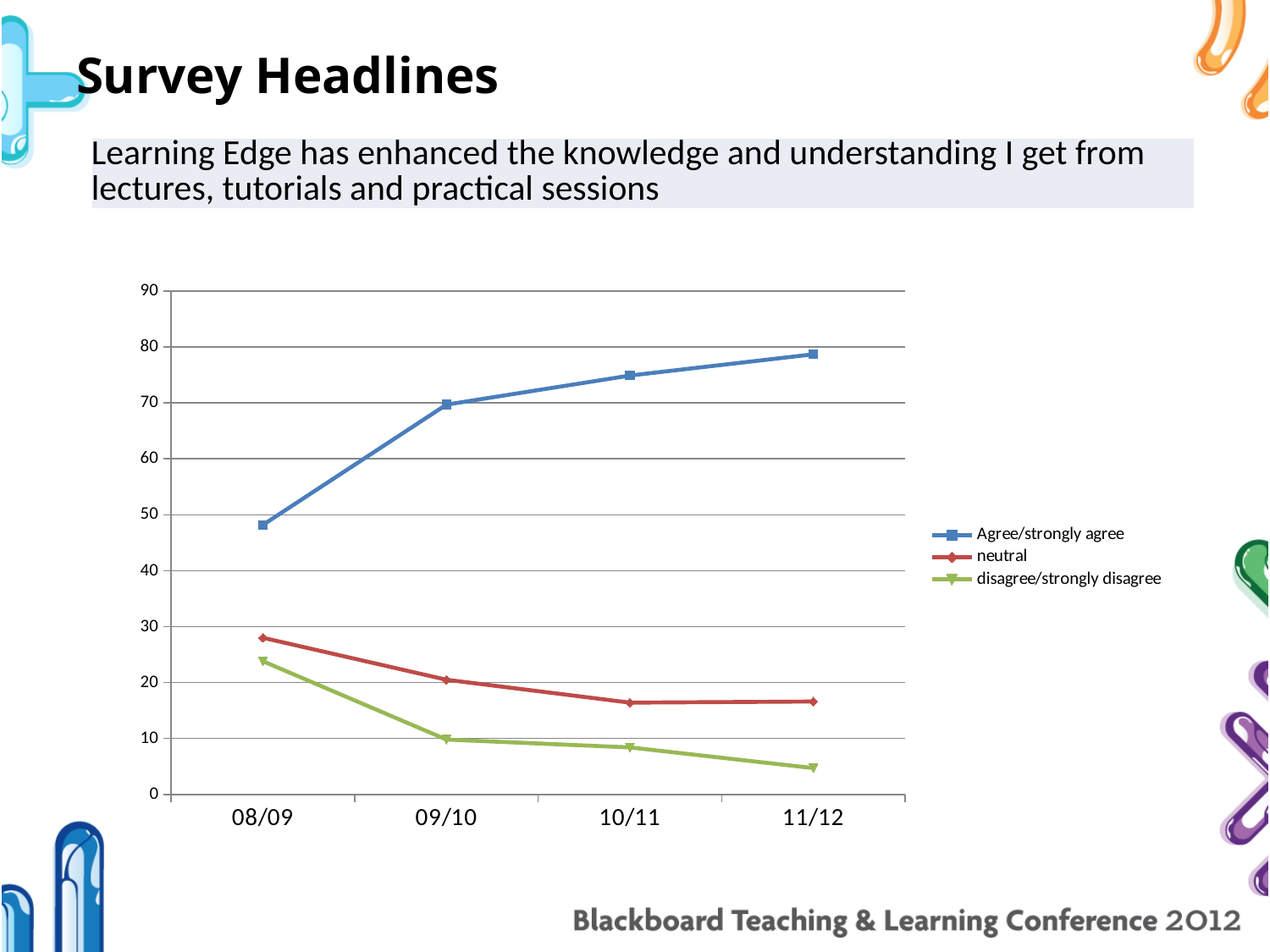
What kind of chart is shown on the slide? line chart Is the value for Agree/strongly agree in 11/12 greater or less than 80? less Does the Agree/strongly agree series rise or fall from 08/09 to 11/12? rise In 09/10, which is larger: the neutral value or the disagree/strongly disagree value? neutral Which series is drawn in green? disagree/strongly disagree In which year is the Agree/strongly agree series at its highest? 11/12 How many points are plotted along the x axis for each series? 4 Is the value for Agree/strongly agree in 08/09 greater or less than 40? greater Is the value for disagree/strongly disagree in 11/12 greater or less than 10? less Does the disagree/strongly disagree series rise or fall from 08/09 to 11/12? fall How many series does the legend list? 3